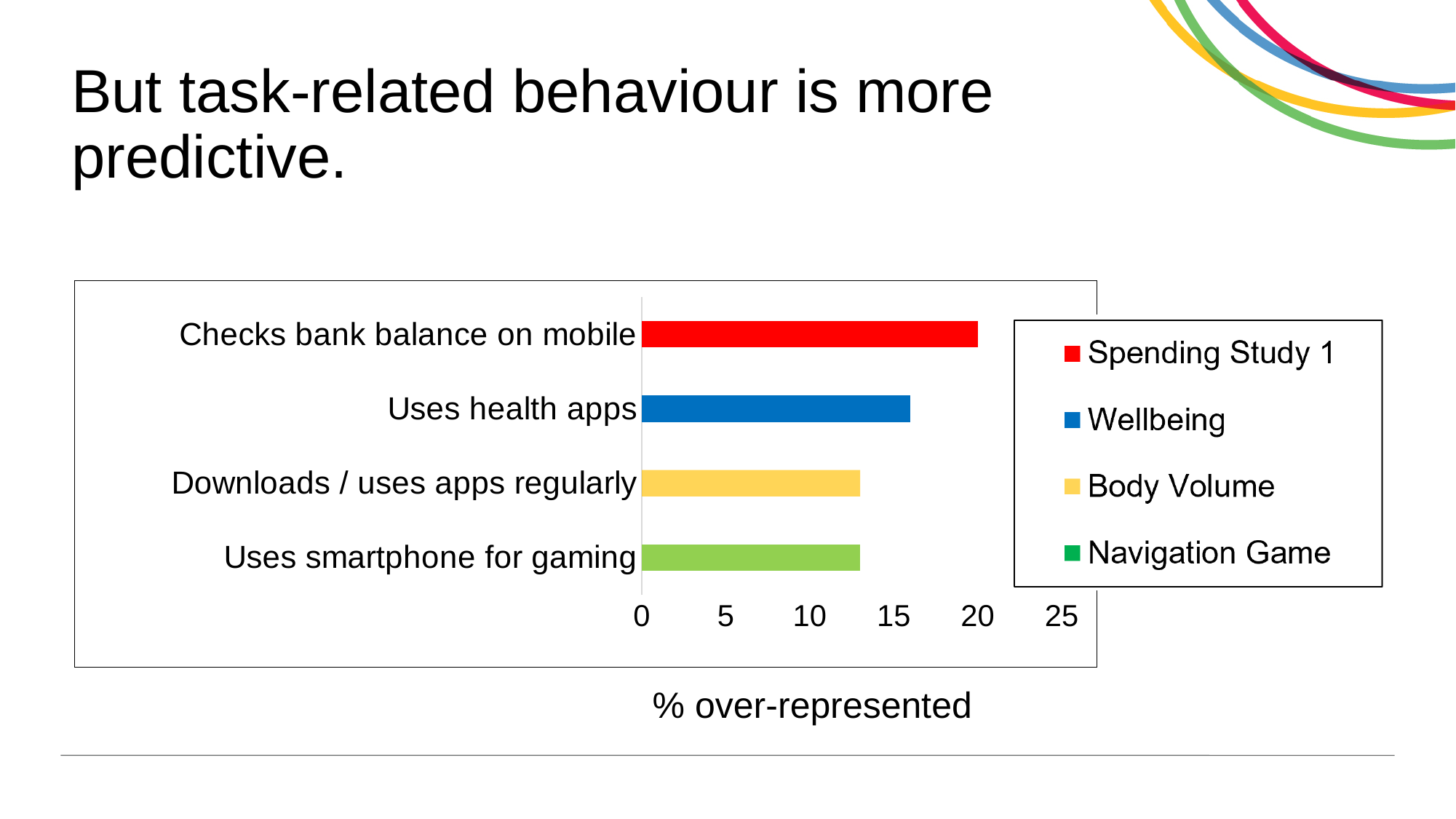
What is the label on the horizontal axis of the chart? % over-represented How many series does the legend list? 4 How many categories are plotted on the chart? 4 Which is larger, the value for Uses health apps or the value for Downloads / uses apps regularly? Uses health apps Which category has the highest value? Checks bank balance on mobile Is the value for Uses smartphone for gaming greater or less than 10? greater Is the value for Downloads / uses apps regularly greater or less than 15? less What kind of chart is shown on the slide? bar chart What is the value for Checks bank balance on mobile? 20 Which is larger, the value for Checks bank balance on mobile or the value for Uses health apps? Checks bank balance on mobile Which legend entry is shown in red? Spending Study 1 Is the value for Uses health apps greater or less than 15? greater